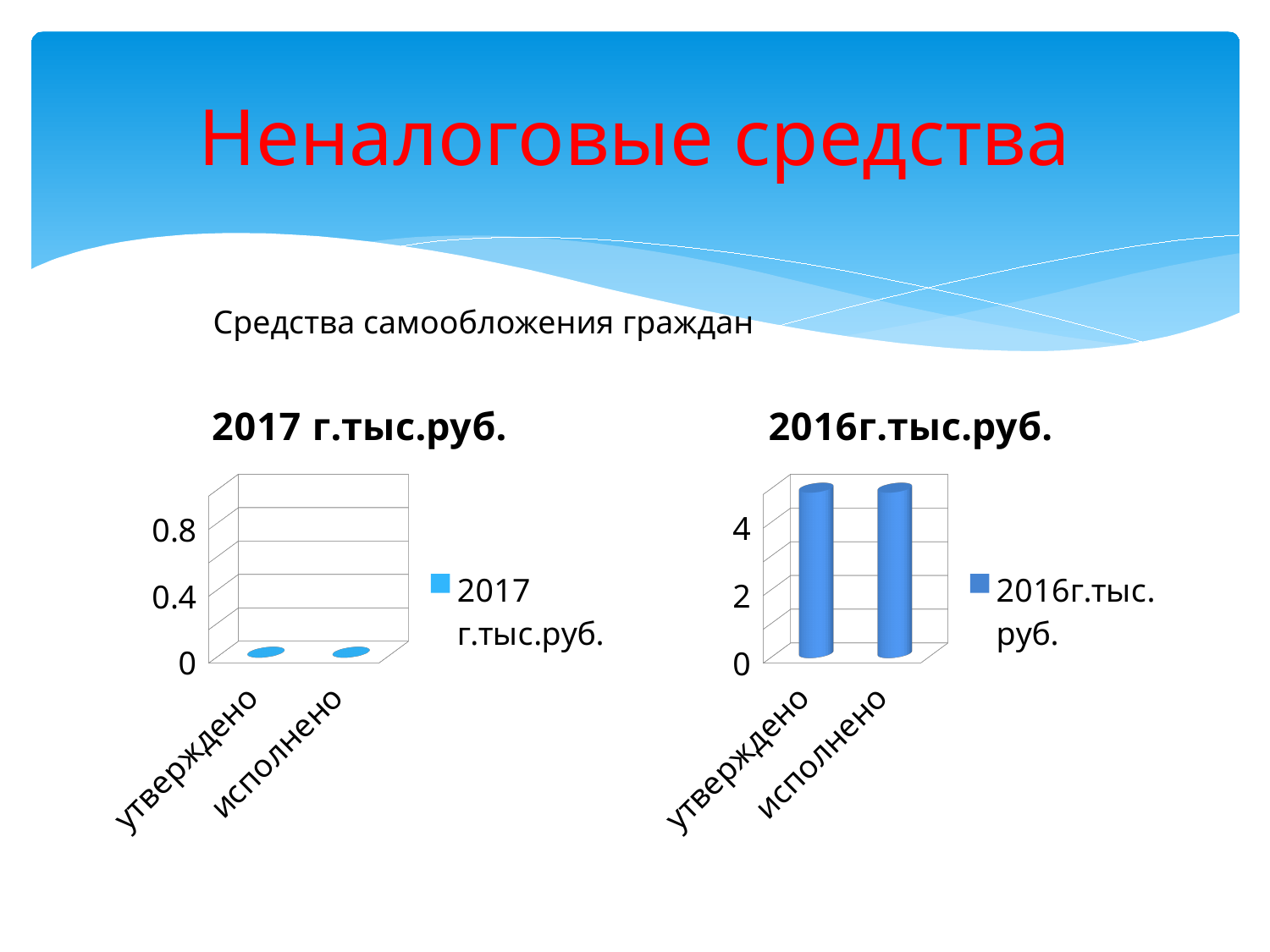
What kind of chart is the chart titled "2016г.тыс.руб."? bar chart In the chart titled "2017 г.тыс.руб.", how many series does the legend list? 1 In the chart titled "2016г.тыс.руб.", how many categories are shown on the x axis? 2 In the chart titled "2017 г.тыс.руб.", what is the value for утверждено? 0 In the chart titled "2017 г.тыс.руб.", how many categories are shown on the x axis? 2 In the chart titled "2016г.тыс.руб.", how many series does the legend list? 1 In the chart titled "2016г.тыс.руб.", is the value for исполнено greater or less than 2? greater In the chart titled "2016г.тыс.руб.", is the value for утверждено greater or less than 4? greater In the chart titled "2016г.тыс.руб.", what is the legend entry? 2016г.тыс.руб. What kind of chart is the chart titled "2017 г.тыс.руб."? bar chart In the chart titled "2017 г.тыс.руб.", what is the value for исполнено? 0 Which chart shows the larger value for утверждено, the chart titled "2017 г.тыс.руб." or the chart titled "2016г.тыс.руб."? 2016г.тыс.руб.